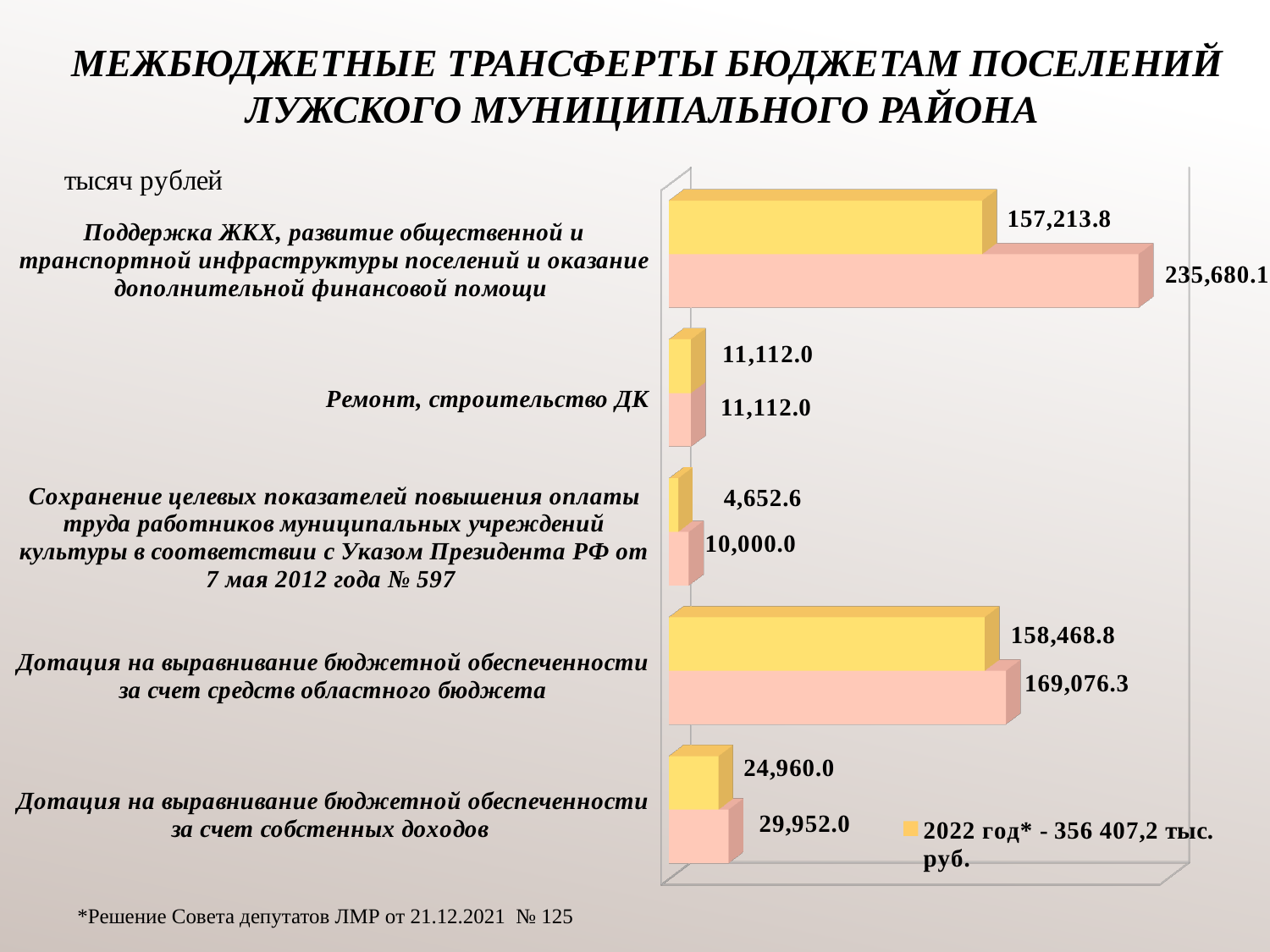
For «Дотация на выравнивание бюджетной обеспеченности за счет собственных доходов», what is the difference between the pink bar and the 2022 bar? 4,992.0 What is the 2022 value for «Дотация на выравнивание бюджетной обеспеченности за счет средств областного бюджета»? 158,468.8 What is the value of the pink bar for «Поддержка ЖКХ, развитие общественной и транспортной инфраструктуры поселений и оказание дополнительной финансовой помощи»? 235,680.1 What is the 2022 value for «Ремонт, строительство ДК»? 11,112.0 What type of chart is shown on the slide? bar chart What is the value of the pink bar for «Сохранение целевых показателей повышения оплаты труда работников муниципальных учреждений культуры...»? 10,000.0 For «Поддержка ЖКХ...», how much larger is the pink bar than the 2022 bar? 78,466.3 For «Сохранение целевых показателей...», which is larger: the 2022 bar or the pink bar? the pink bar Which category has the highest 2022 value? Дотация на выравнивание бюджетной обеспеченности за счет средств областного бюджета In what units are the values on the chart given? тысяч рублей Which category has the lowest 2022 value? Сохранение целевых показателей повышения оплаты труда работников муниципальных учреждений культуры в соответствии с Указом Президента РФ от 7 мая 2012 года № 597 How many categories are shown in the chart? 5